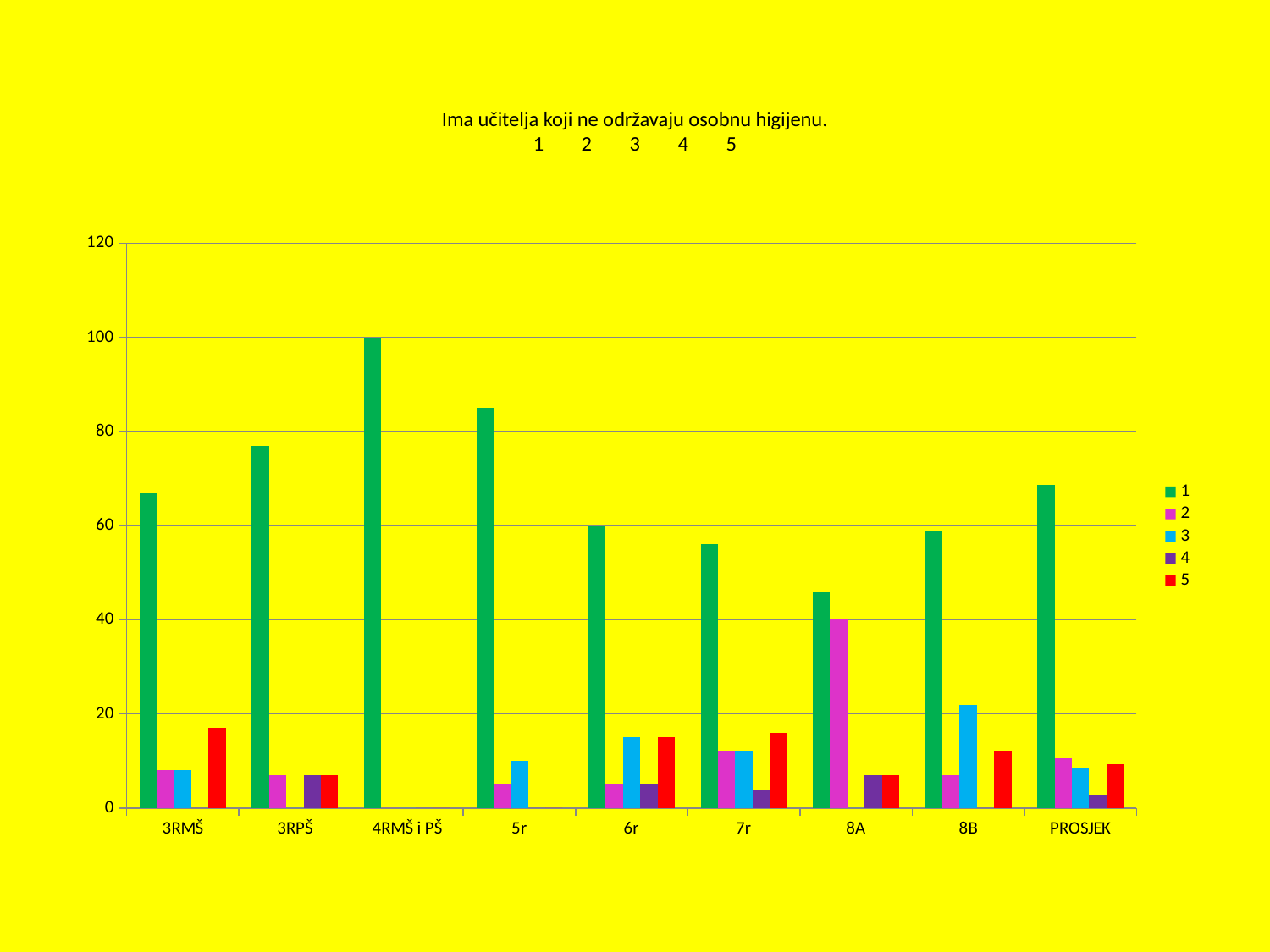
What is the value for series 1 in the 4RMŠ i PŠ category? 100 Is the value for series 1 in 3RMŠ greater or less than 60? greater Is the value for series 1 in PROSJEK greater or less than 60? greater Which is larger for series 1: 3RPŠ or 5r? 5r In the 6r category, which is larger: series 2 or series 3? series 3 What kind of chart is shown on the slide? bar chart How many series does the legend list? 5 Which category has the highest value for series 1? 4RMŠ i PŠ How many categories are shown on the x axis? 9 What is the title of the chart? Ima učitelja koji ne održavaju osobnu higijenu. Is the value for series 2 in 8A greater or less than 20? greater Which category has the lowest value for series 1? 8A